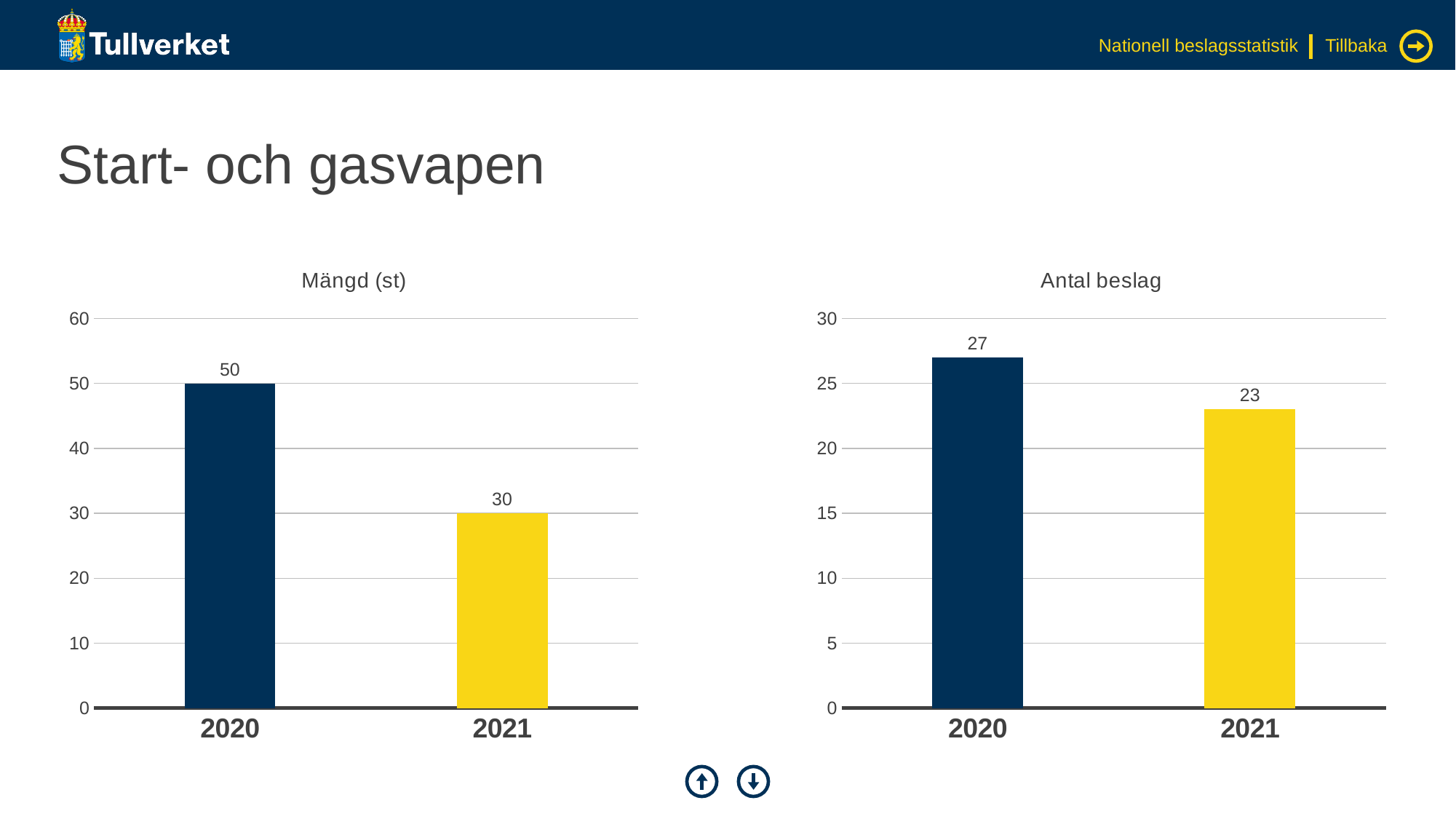
In the 'Mängd (st)' chart, which year has the highest value? 2020 What kind of chart is the 'Antal beslag' chart? bar chart In the 'Mängd (st)' chart, what is the value for 2020? 50 In the 'Antal beslag' chart, which year has the lowest value? 2021 In the 'Antal beslag' chart, what is the difference between the 2020 and 2021 values? 4 In the 'Mängd (st)' chart, how many categories are shown on the x axis? 2 In the 'Antal beslag' chart, what is the value for 2020? 27 In the 'Antal beslag' chart, what is the value for 2021? 23 In the 'Mängd (st)' chart, what is the difference between the 2020 and 2021 values? 20 In the 'Antal beslag' chart, is the value for 2020 greater or less than 25? greater In the 'Mängd (st)' chart, what is the value for 2021? 30 In the 'Mängd (st)' chart, do the values rise or fall from 2020 to 2021? fall